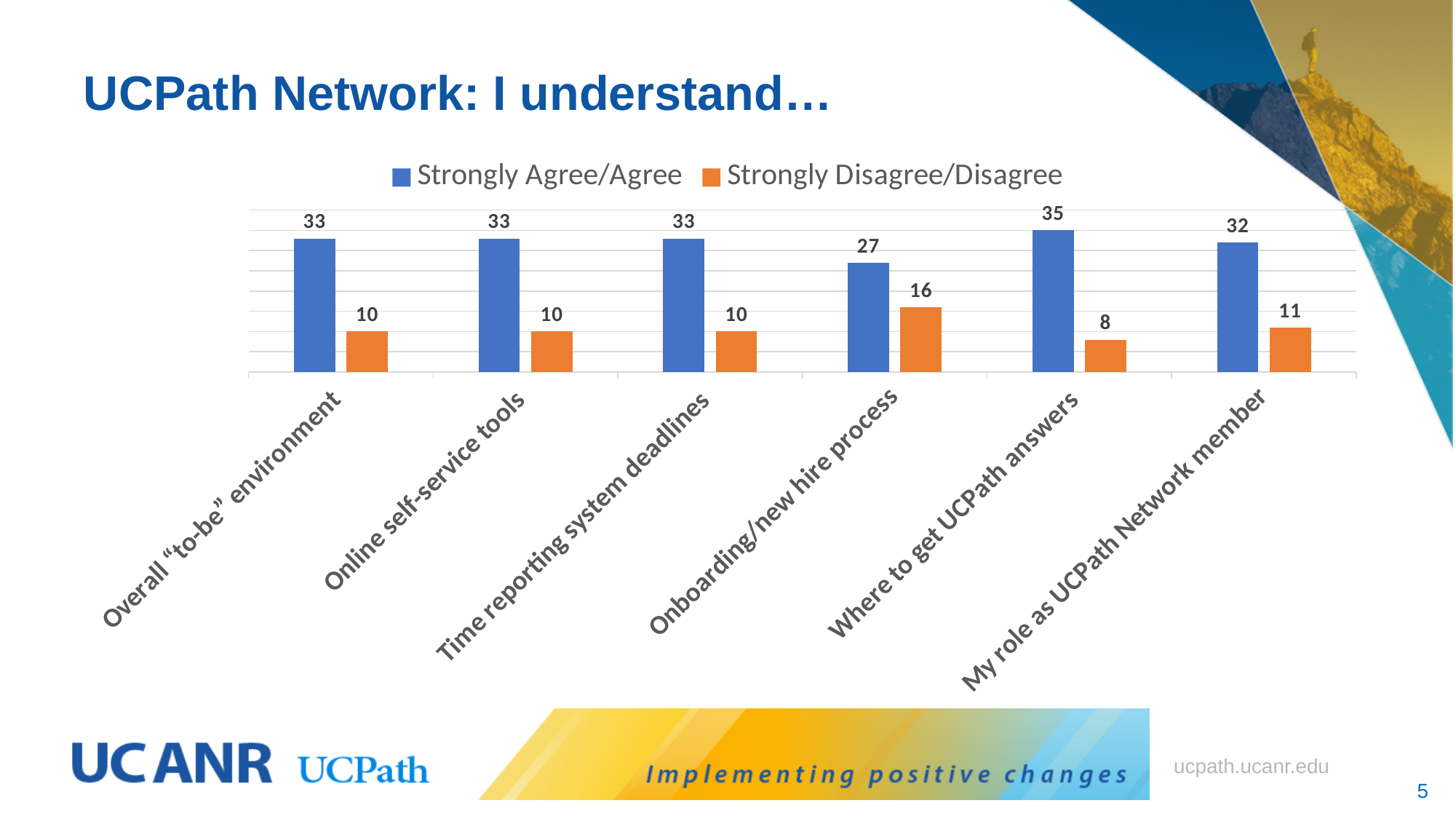
What kind of chart is shown on the slide? Bar chart How many series does the legend list? 2 Which category has the highest Strongly Disagree/Disagree value? Onboarding/new hire process Which category has the highest Strongly Agree/Agree value? Where to get UCPath answers What is the difference between the Strongly Agree/Agree and Strongly Disagree/Disagree values for "Where to get UCPath answers"? 27 Which category has the lowest Strongly Disagree/Disagree value? Where to get UCPath answers What is the Strongly Agree/Agree value for "My role as UCPath Network member"? 32 How many categories are shown on the x axis? 6 Which is larger: the Strongly Disagree/Disagree value for "Onboarding/new hire process" or for "My role as UCPath Network member"? Onboarding/new hire process What is the Strongly Agree/Agree value for "Where to get UCPath answers"? 35 What is the Strongly Disagree/Disagree value for "Onboarding/new hire process"? 16 Which category has the lowest Strongly Agree/Agree value? Onboarding/new hire process